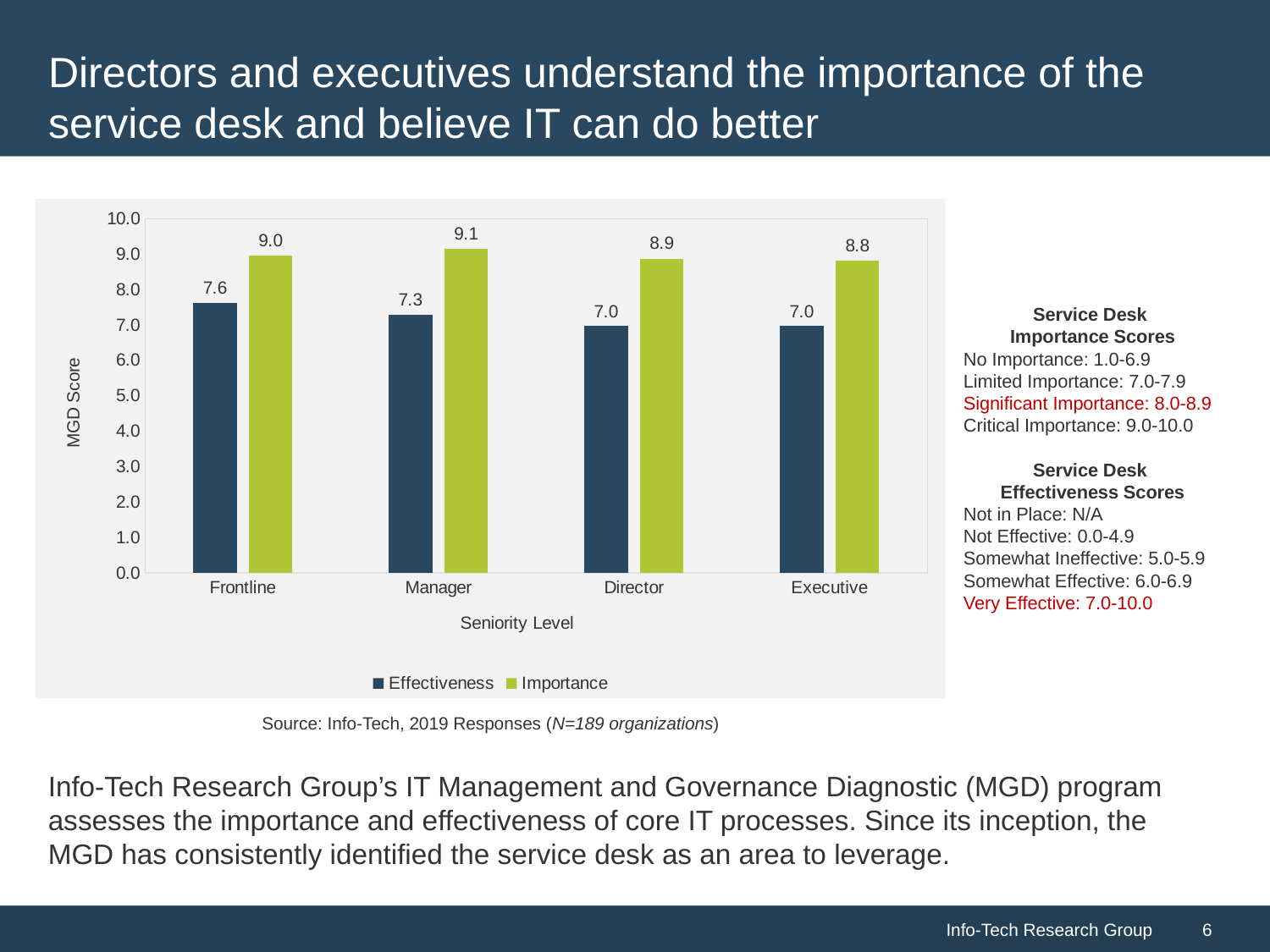
What kind of chart is shown on the slide? Bar chart What is the difference between the Importance and Effectiveness scores for Director? 1.9 What is the Effectiveness score for Frontline? 7.6 What is the label of the y axis? MGD Score How many seniority levels are shown on the x axis? 4 Which seniority level has the highest Effectiveness score? Frontline Which is larger, the Importance score for Frontline or the Importance score for Director? Frontline How many series does the legend list? 2 What is the Importance score for Executive? 8.8 Which seniority level has the highest Importance score? Manager What is the Importance score for Manager? 9.1 What is the difference between the Effectiveness scores for Frontline and Manager? 0.3